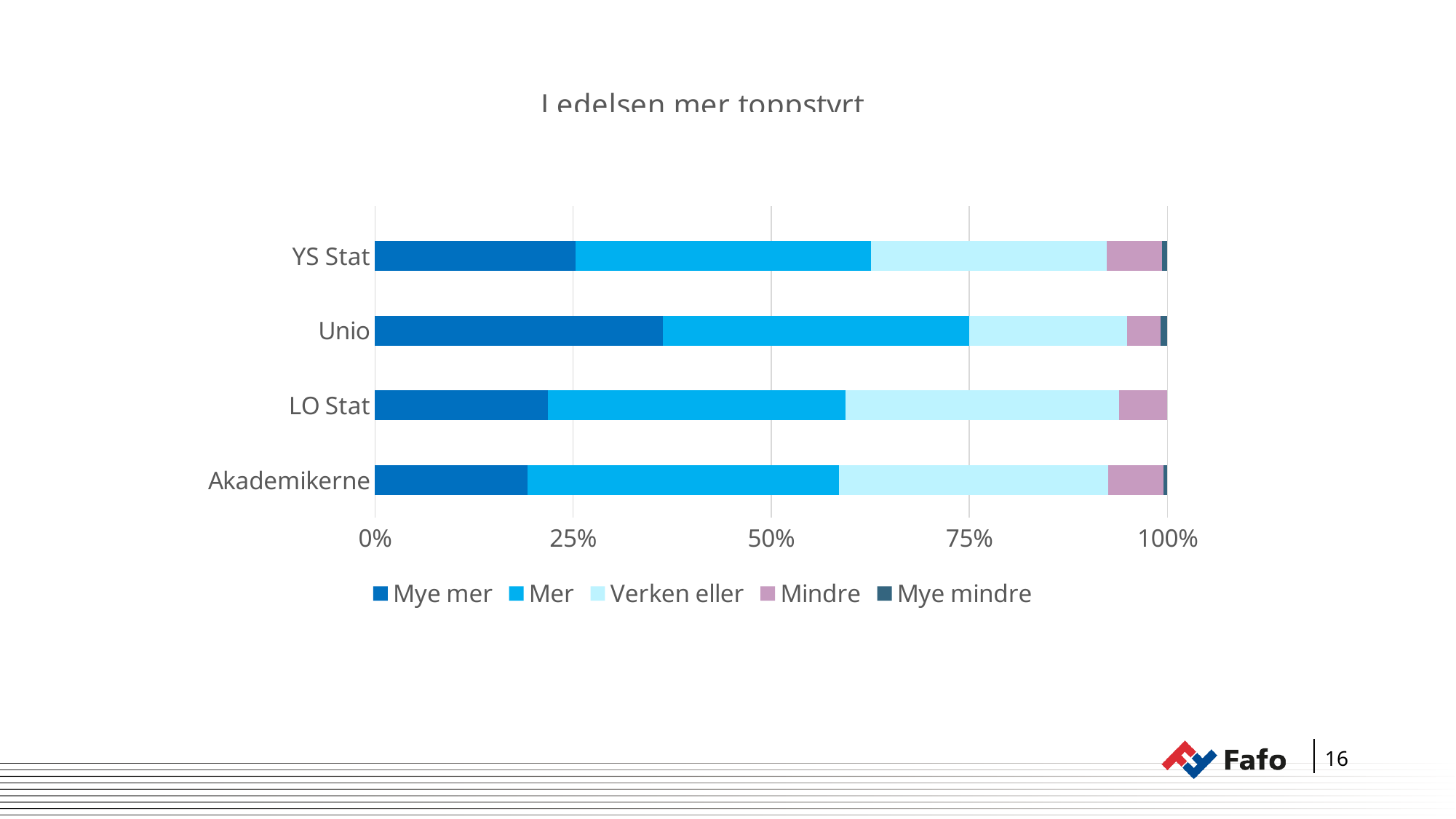
How many categories (organisations) are shown on the y axis of the chart? 4 Which category shows no visible 'Mye mindre' segment? LO Stat Which category has the largest 'Mye mer' segment? Unio Is the 'Mye mer' value for LO Stat greater or less than 25%? less Is the 'Mye mer' value for Akademikerne greater or less than 25%? less Is the 'Mye mer' value for Unio greater or less than 25%? greater What kind of chart is shown on the slide? Stacked bar chart How many series does the chart legend list? 5 Which is larger, the 'Mye mer' segment for Unio or for YS Stat? Unio What is the first entry in the chart legend? Mye mer